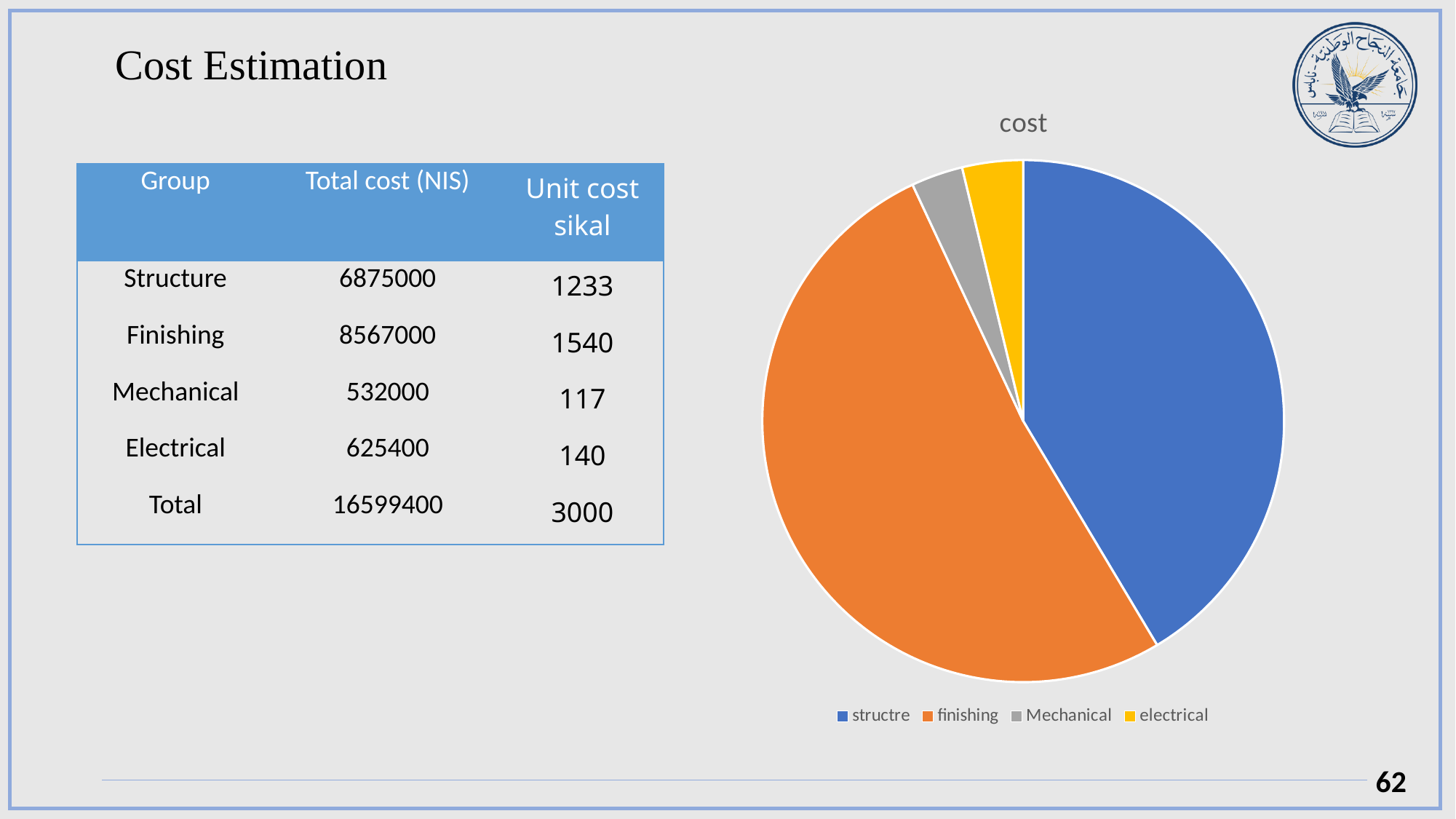
What kind of chart is shown on the slide? pie chart Which category has the smallest slice in the pie chart? Mechanical In the pie chart, which slice is larger: structre or finishing? finishing In the pie chart, which slice is larger: structre or electrical? structre How many entries does the legend of the pie chart list? 4 Which colour represents the finishing slice in the pie chart? orange In the pie chart, which slice is larger: electrical or Mechanical? electrical What is the title of the pie chart? cost Which category has the largest slice in the pie chart? finishing How many slices does the pie chart have? 4